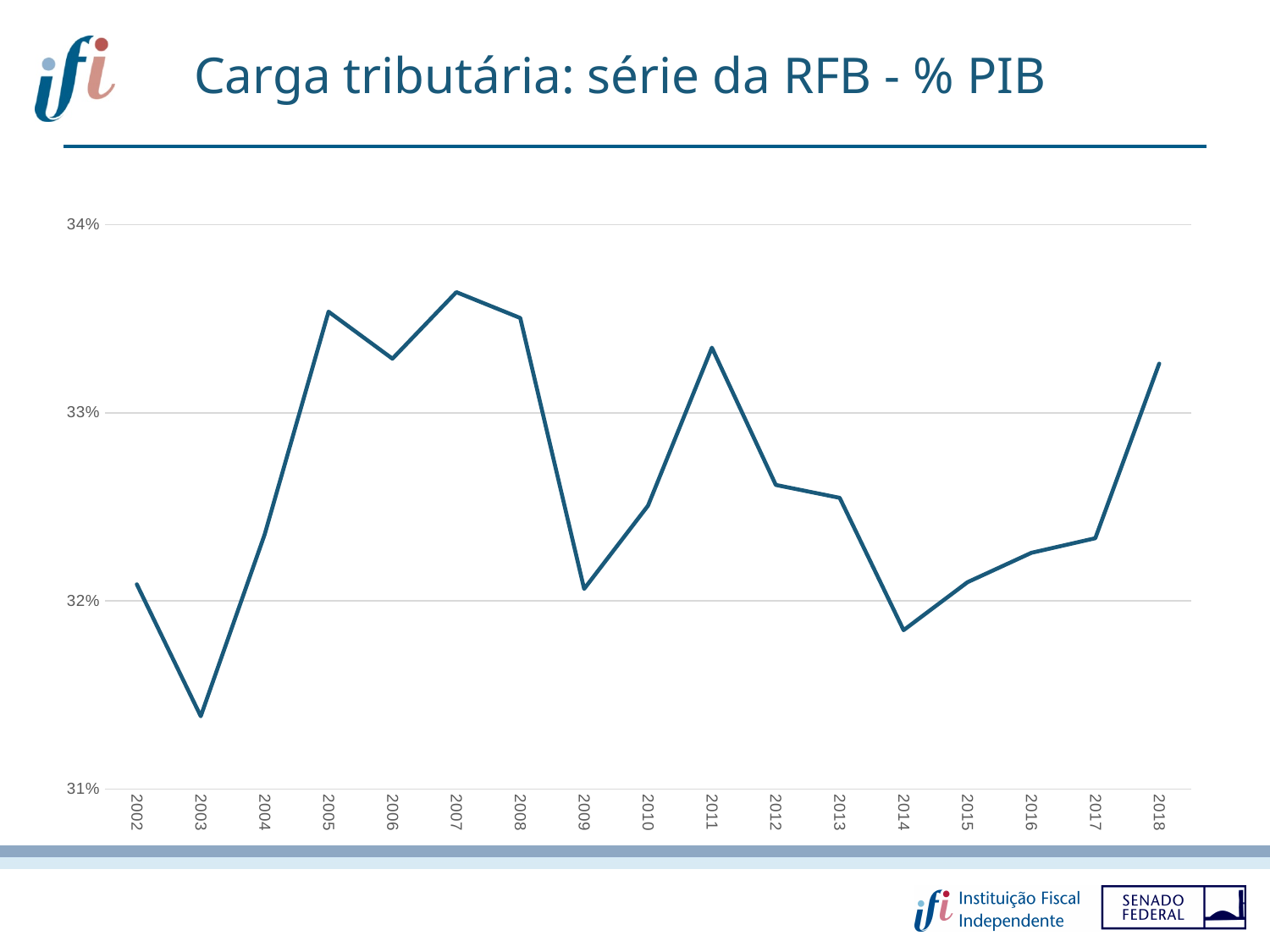
How many years are plotted on the x axis? 17 Which year has the lowest value? 2003 Is the value for 2010 greater or less than 33%? less Which is larger, the value for 2011 or the value for 2012? 2011 What kind of chart is shown on the slide? line chart What is the title of the chart? Carga tributária: série da RFB - % PIB Is the value for 2005 greater or less than 33%? greater Is the value for 2018 greater or less than 33%? greater Which year has the highest value? 2007 Do the values rise or fall from 2014 to 2018? rise